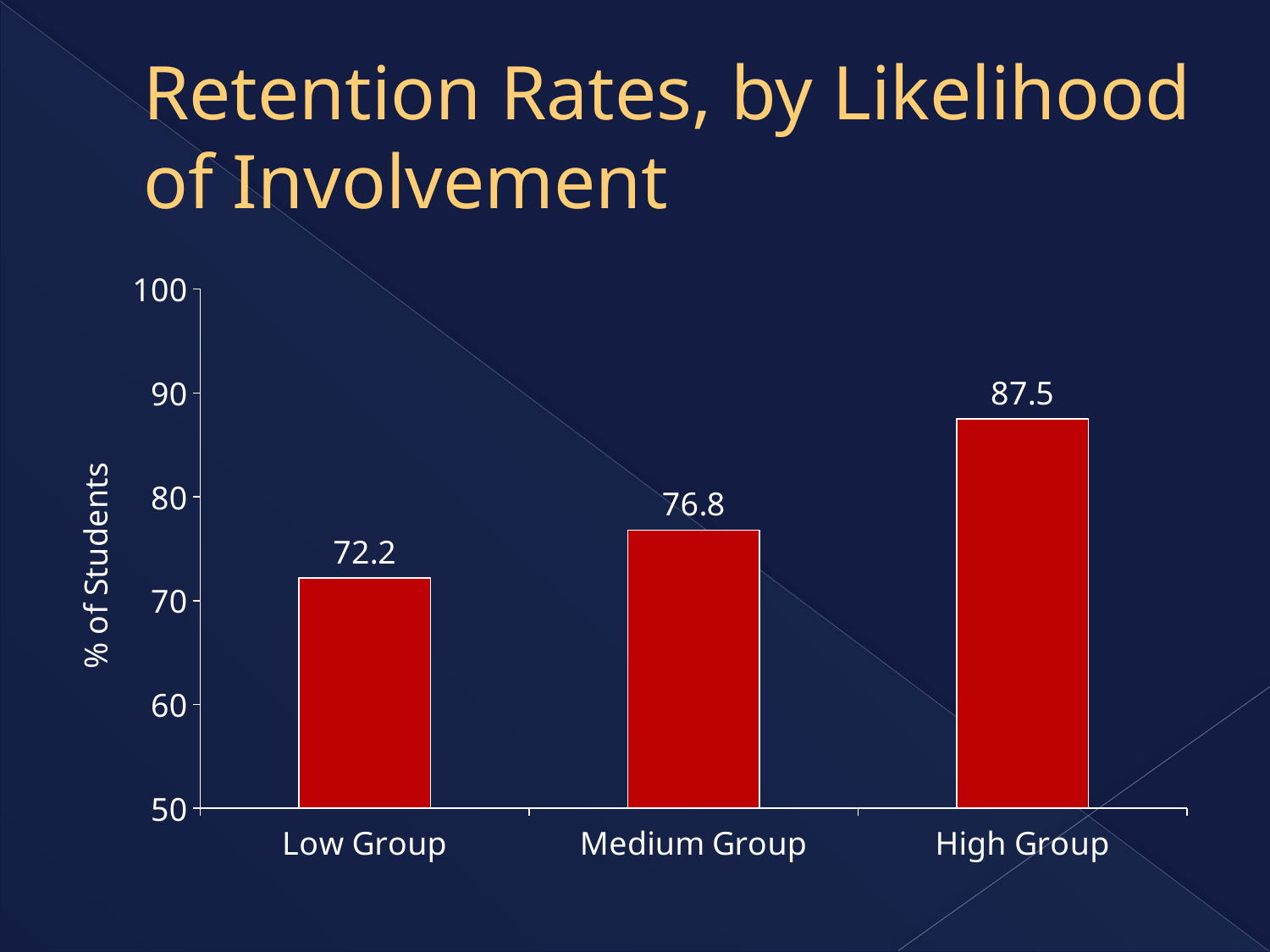
What is the difference in retention rate between the Medium Group and the Low Group? 4.6 What kind of chart is shown on the slide? bar chart Is the value for the Medium Group greater or less than 80? less What is the difference in retention rate between the High Group and the Low Group? 15.3 What is the retention rate for the Low Group? 72.2 Which group has the highest retention rate? High Group How many groups are shown on the chart? 3 Do the retention rates rise or fall from the Low Group to the High Group? rise What is the retention rate for the High Group? 87.5 Which has a higher retention rate, the Medium Group or the High Group? High Group Which group has the lowest retention rate? Low Group What is the retention rate for the Medium Group? 76.8